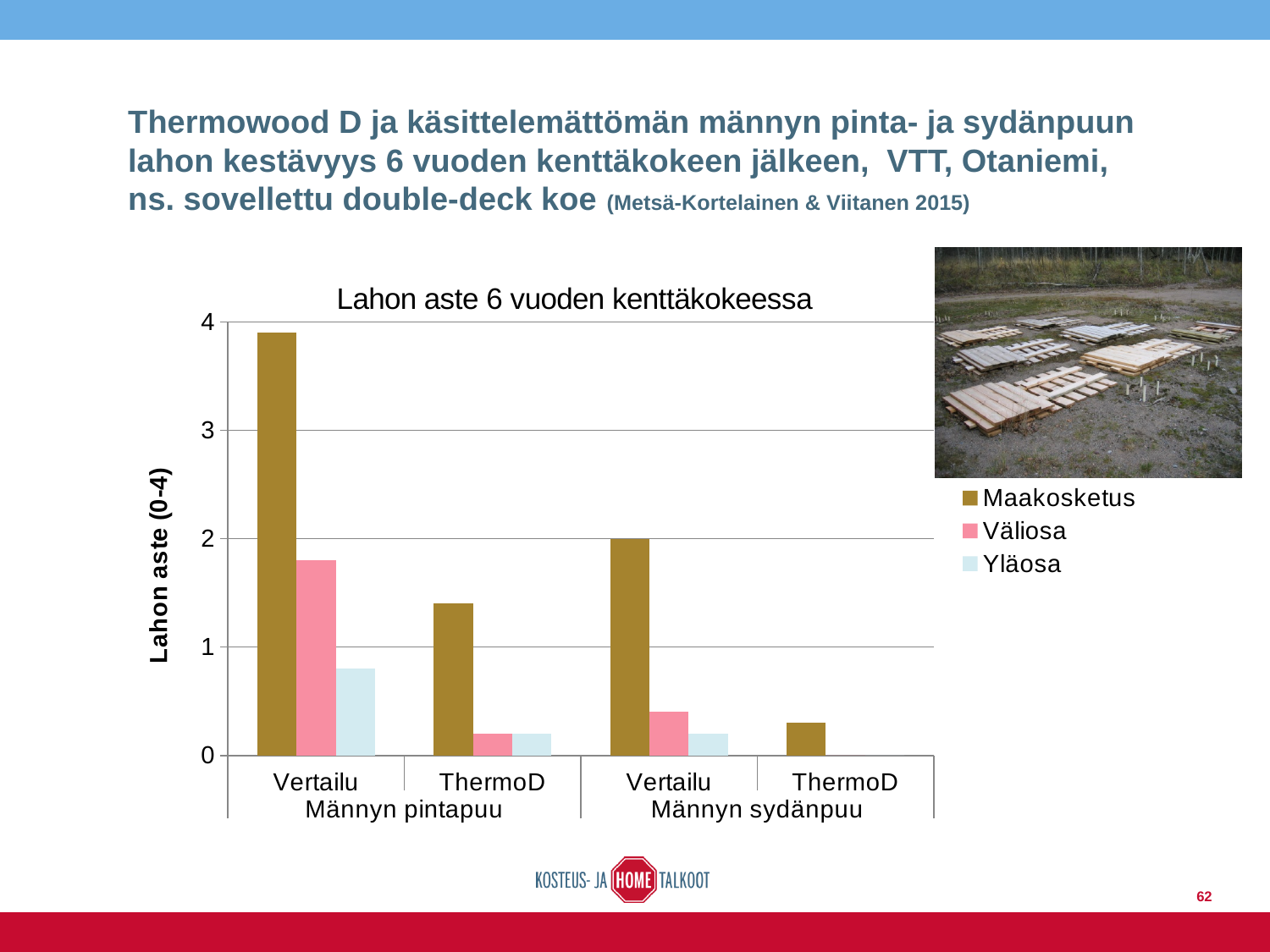
Is the Maakosketus value for Vertailu in Männyn pintapuu greater or less than 3? greater Which bar group has the lowest Maakosketus value? ThermoD (Männyn sydänpuu) Is the Maakosketus value for ThermoD in Männyn pintapuu greater or less than 2? less Which is larger: the Maakosketus value for Vertailu in Männyn pintapuu or for Vertailu in Männyn sydänpuu? Vertailu in Männyn pintapuu Is the Maakosketus value for ThermoD in Männyn sydänpuu greater or less than 1? less What is the title of the chart? Lahon aste 6 vuoden kenttäkokeessa Which bar group has the highest Maakosketus value? Vertailu (Männyn pintapuu) Which series is shown in pink in the chart? Väliosa How many series does the chart legend list? 3 What type of chart is shown on the slide? bar chart How many bar groups (categories) are shown along the x axis? 4